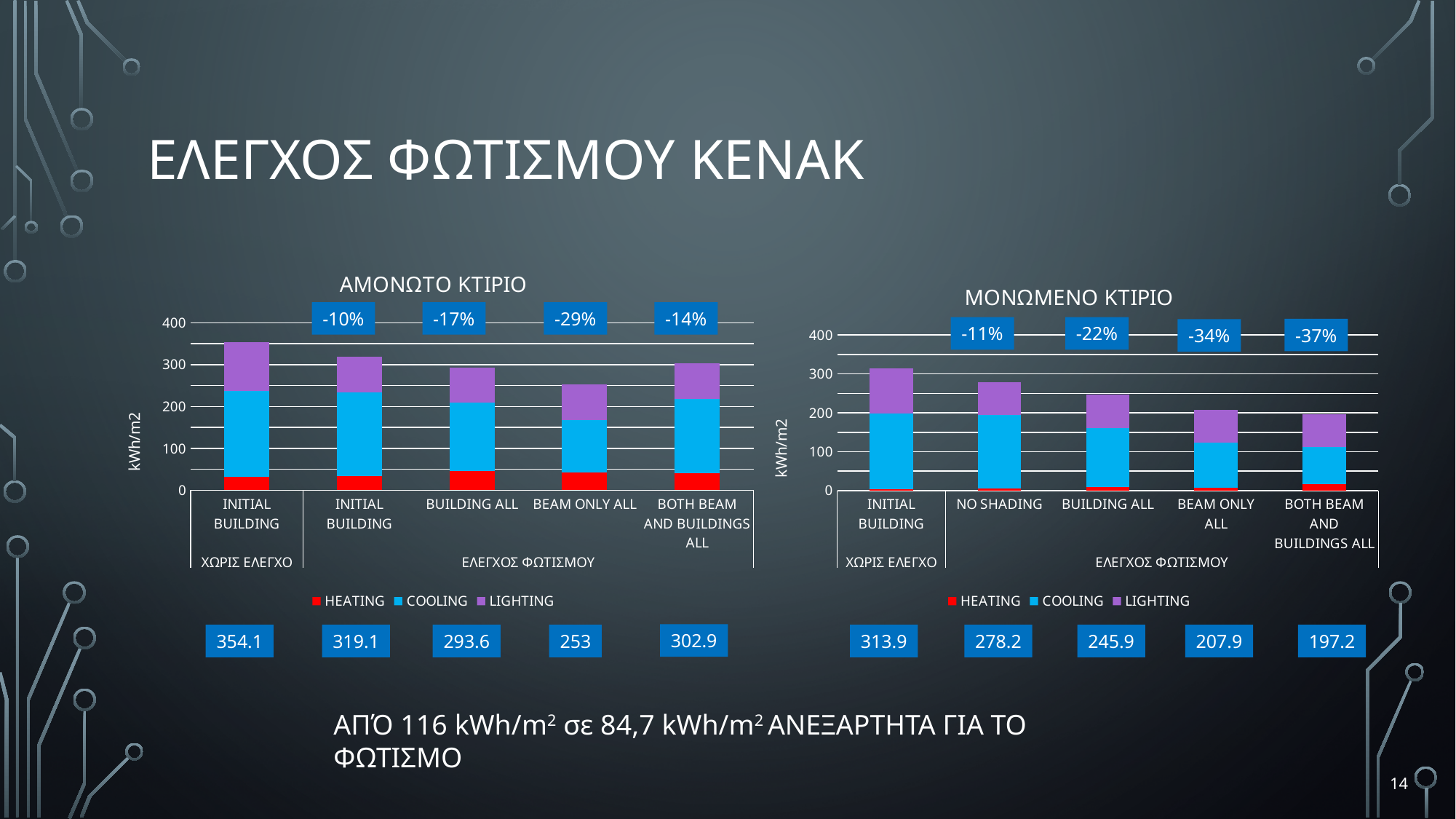
In the ΜΟΝΩΜΕΝΟ ΚΤΙΡΙΟ chart, what percentage change is shown above the BEAM ONLY ALL bar? -34% In the ΑΜΟΝΩΤΟ ΚΤΙΡΙΟ chart, what is the difference between the totals for INITIAL BUILDING (ΧΩΡΙΣ ΕΛΕΓΧΟ) and BUILDING ALL? 60.5 How many series does the legend of the ΜΟΝΩΜΕΝΟ ΚΤΙΡΙΟ chart list? 3 In the ΜΟΝΩΜΕΝΟ ΚΤΙΡΙΟ chart, which category has the highest total? INITIAL BUILDING Which is larger: the total for NO SHADING in the ΜΟΝΩΜΕΝΟ ΚΤΙΡΙΟ chart or the total for BUILDING ALL in the ΑΜΟΝΩΤΟ ΚΤΙΡΙΟ chart? BUILDING ALL in the ΑΜΟΝΩΤΟ ΚΤΙΡΙΟ chart What type of chart is the ΑΜΟΝΩΤΟ ΚΤΙΡΙΟ chart? stacked bar chart How many bars are plotted in the ΑΜΟΝΩΤΟ ΚΤΙΡΙΟ chart? 5 In the ΑΜΟΝΩΤΟ ΚΤΙΡΙΟ chart, what is the total value shown for BEAM ONLY ALL? 253 In the ΑΜΟΝΩΤΟ ΚΤΙΡΙΟ chart, what percentage change is shown above the BOTH BEAM AND BUILDINGS ALL bar? -14% In the ΜΟΝΩΜΕΝΟ ΚΤΙΡΙΟ chart, is the COOLING value for INITIAL BUILDING greater or less than 100? greater In the ΑΜΟΝΩΤΟ ΚΤΙΡΙΟ chart, which category has the lowest total? BEAM ONLY ALL In the ΜΟΝΩΜΕΝΟ ΚΤΙΡΙΟ chart, what is the total value shown for BOTH BEAM AND BUILDINGS ALL? 197.2